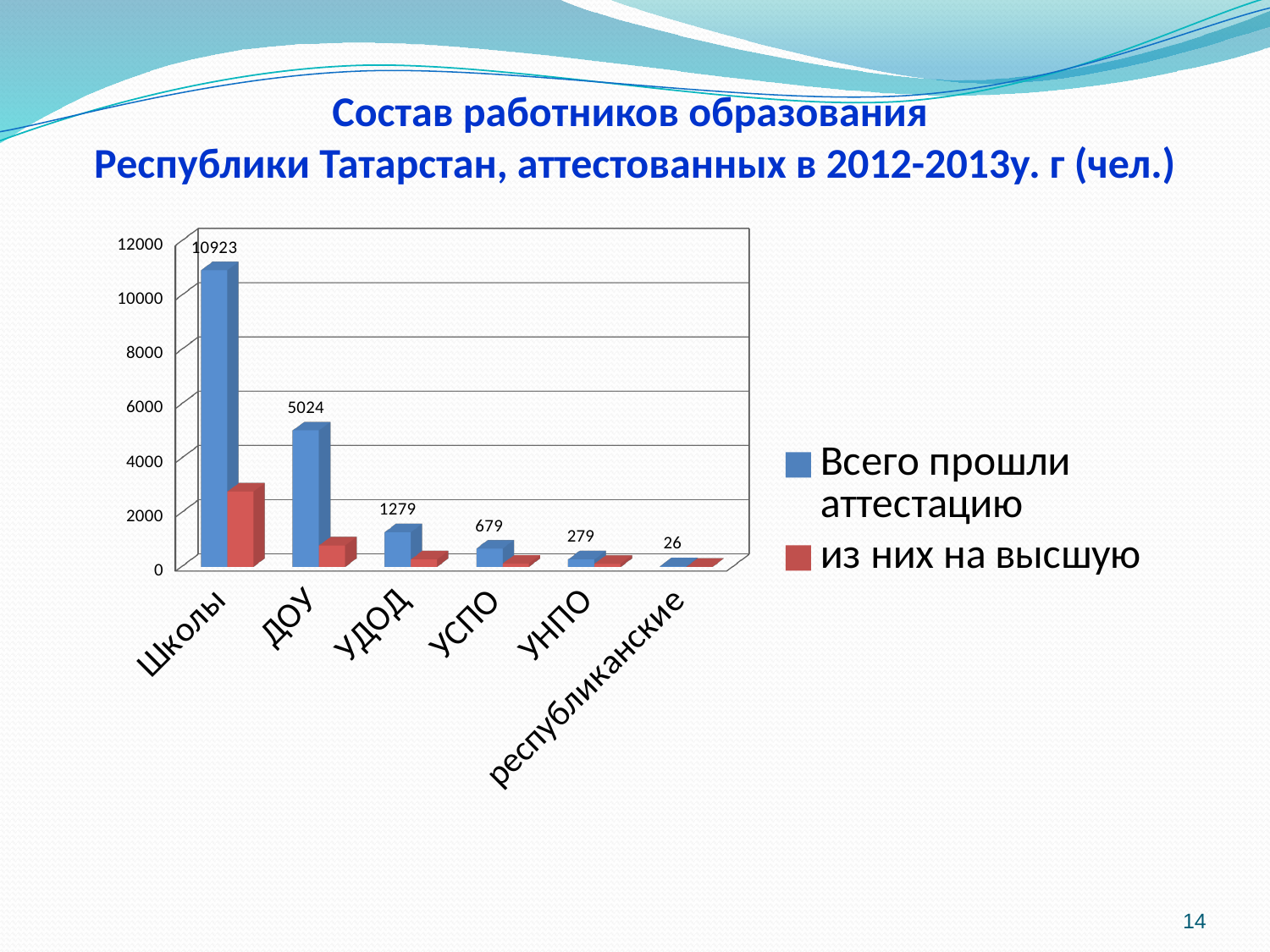
What is the difference between the "Всего прошли аттестацию" values for Школы and ДОУ? 5899 What is the value of "Всего прошли аттестацию" for республиканские? 26 Which category has the highest value for "Всего прошли аттестацию"? Школы Which category has the lowest value for "Всего прошли аттестацию"? республиканские What is the value of "Всего прошли аттестацию" for Школы? 10923 How many series does the legend list? 2 What is the value of "Всего прошли аттестацию" for УДОД? 1279 Is the value of "из них на высшую" for Школы greater or less than 2000? greater What kind of chart is shown on the slide? bar chart Which has a larger "Всего прошли аттестацию" value, УСПО or УНПО? УСПО How many categories are shown on the x axis? 6 What is the value of "Всего прошли аттестацию" for ДОУ? 5024